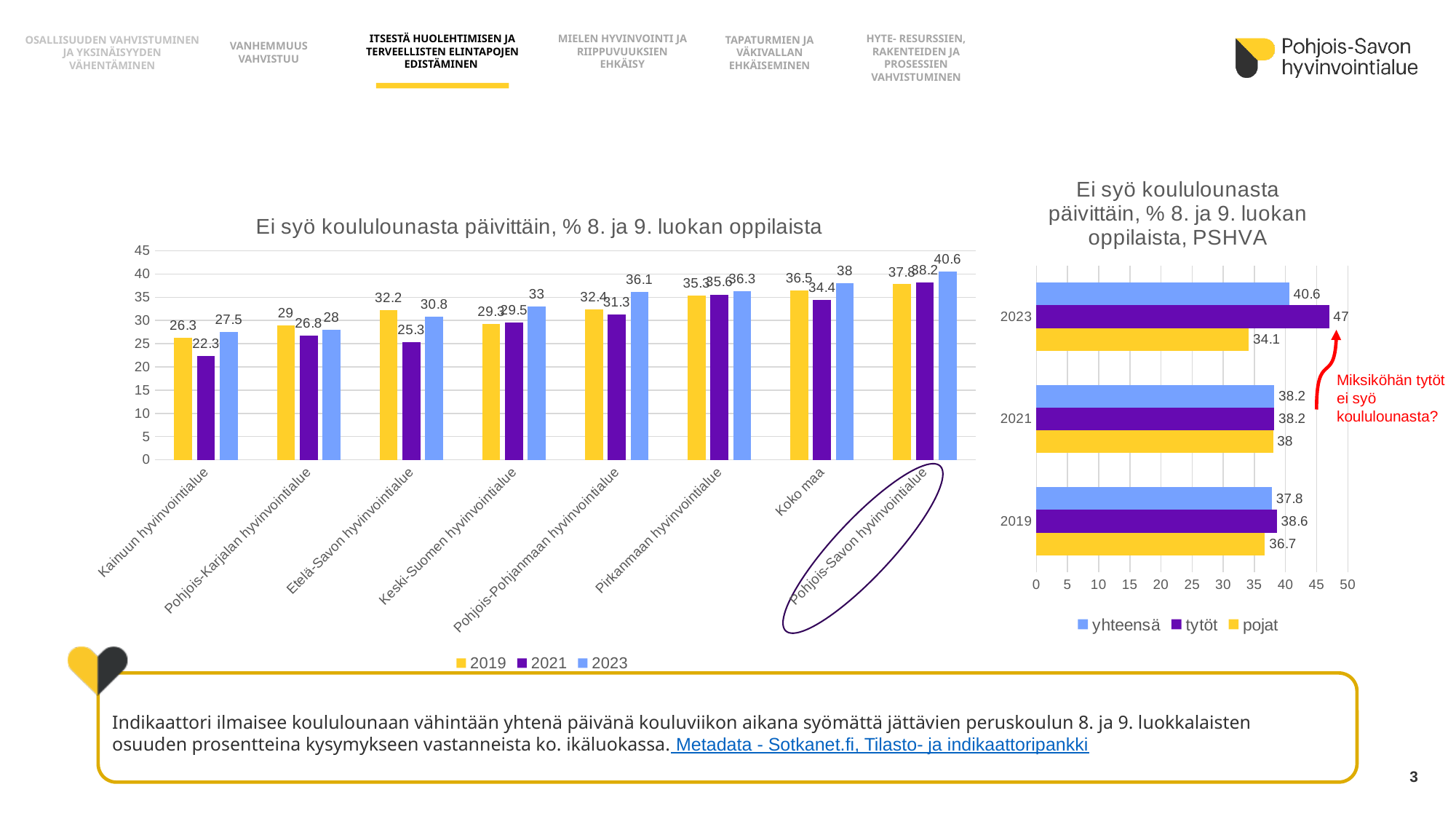
In the left chart, how many categories are shown on the x axis? 8 In the left chart, what is the 2023 value for Koko maa? 38 In the left chart, which category has the lowest 2021 value? Kainuun hyvinvointialue In the left chart, how many series does the legend list? 3 In the right chart (PSHVA), what is the value for tytöt in 2023? 47 In the left chart, what is the 2023 value for Kainuun hyvinvointialue? 27.5 In the left chart, what is the 2021 value for Etelä-Savon hyvinvointialue? 25.3 What kind of chart is the right chart (PSHVA)? bar chart In the right chart (PSHVA), what is the value for pojat in 2019? 36.7 In the left chart, which category has the highest 2023 value? Pohjois-Savon hyvinvointialue In the right chart (PSHVA), which is larger in 2023: tytöt or pojat? tytöt In the left chart, what is the difference between the 2023 and 2019 values for Pohjois-Pohjanmaan hyvinvointialue? 3.7